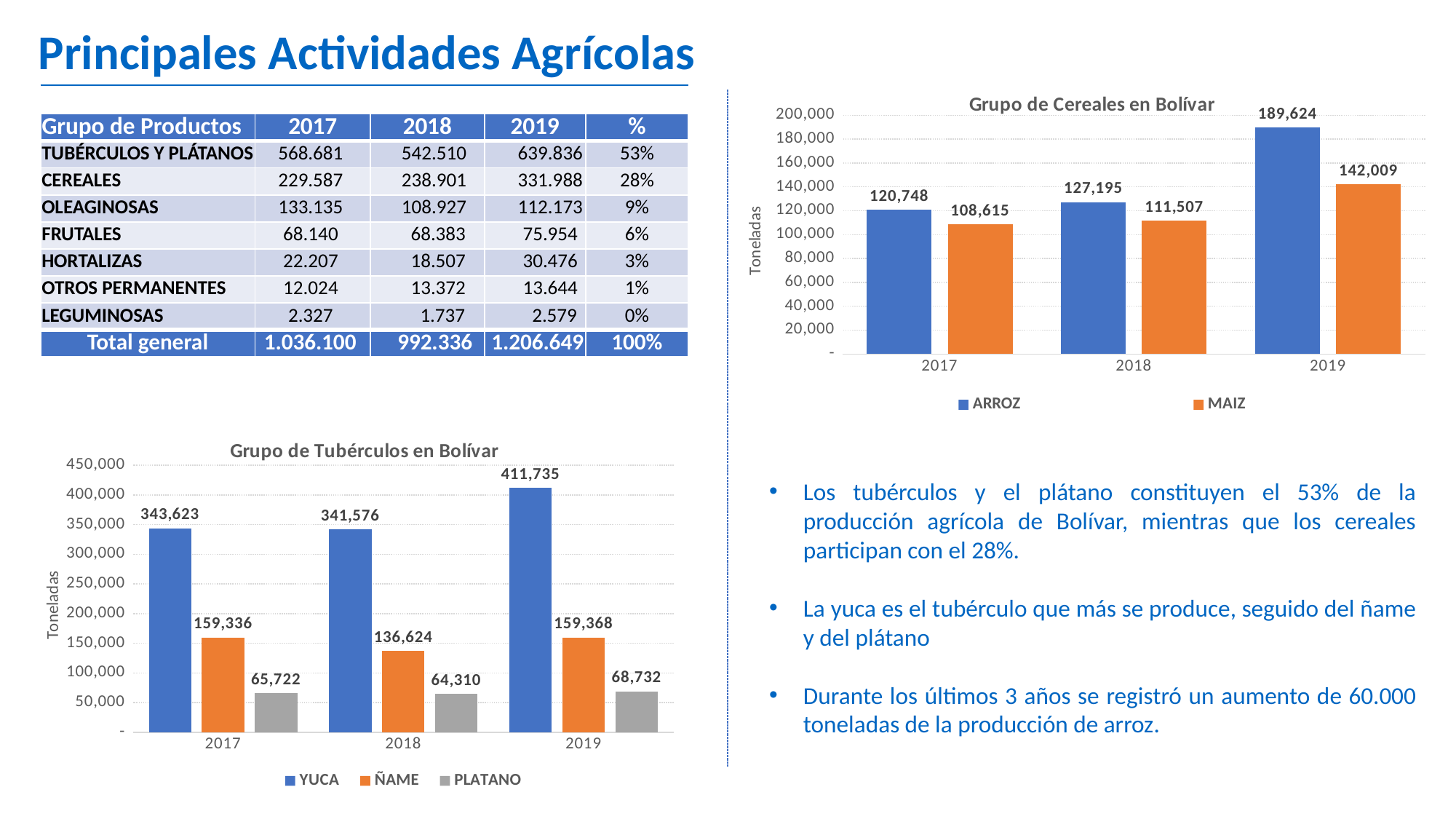
In the 'Grupo de Tubérculos en Bolívar' chart, what is the value for ÑAME in 2018? 136,624 In the 'Grupo de Tubérculos en Bolívar' chart, which series has the lowest value in 2017? PLATANO In the 'Grupo de Tubérculos en Bolívar' chart, how many series does the legend list? 3 In the 'Grupo de Tubérculos en Bolívar' chart, what is the difference between YUCA in 2019 and YUCA in 2018? 70,159 In the 'Grupo de Cereales en Bolívar' chart, what is the difference between ARROZ and MAIZ in 2019? 47,615 What kind of chart is 'Grupo de Cereales en Bolívar'? bar chart In the 'Grupo de Cereales en Bolívar' chart, does the ARROZ value rise or fall from 2017 to 2019? rise In the 'Grupo de Cereales en Bolívar' chart, how many series does the legend list? 2 In the 'Grupo de Tubérculos en Bolívar' chart, which is larger: PLATANO in 2017 or PLATANO in 2019? PLATANO in 2019 In the 'Grupo de Tubérculos en Bolívar' chart, what is the value for YUCA in 2019? 411,735 In the 'Grupo de Cereales en Bolívar' chart, what is the value for ARROZ in 2019? 189,624 In the 'Grupo de Cereales en Bolívar' chart, what is the value for MAIZ in 2017? 108,615